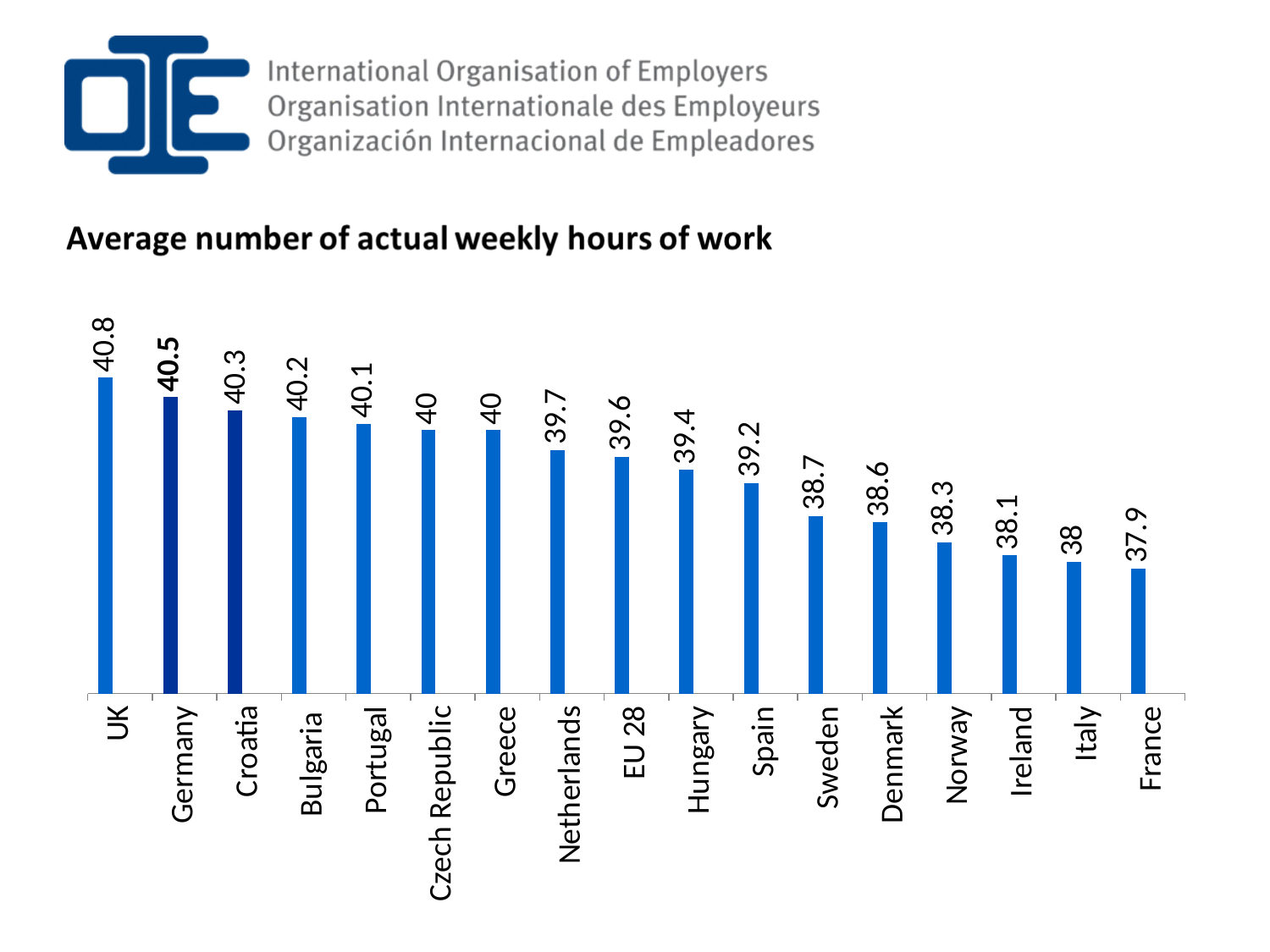
What is the average number of actual weekly hours of work for Germany? 40.5 Do the values rise or fall from left to right along the x axis? Fall What is the difference between the values for Germany and Italy? 2.5 Which has a higher value, Norway or Croatia? Croatia What is the difference between the values for UK and France? 2.9 What is the value shown for Sweden? 38.7 Which country has the highest average number of actual weekly hours of work? UK How many categories are shown on the chart? 17 What is the value shown for EU 28? 39.6 What kind of chart is shown on the slide? Bar chart Which country has the lowest average number of actual weekly hours of work? France Which has a higher value, Netherlands or Hungary? Netherlands